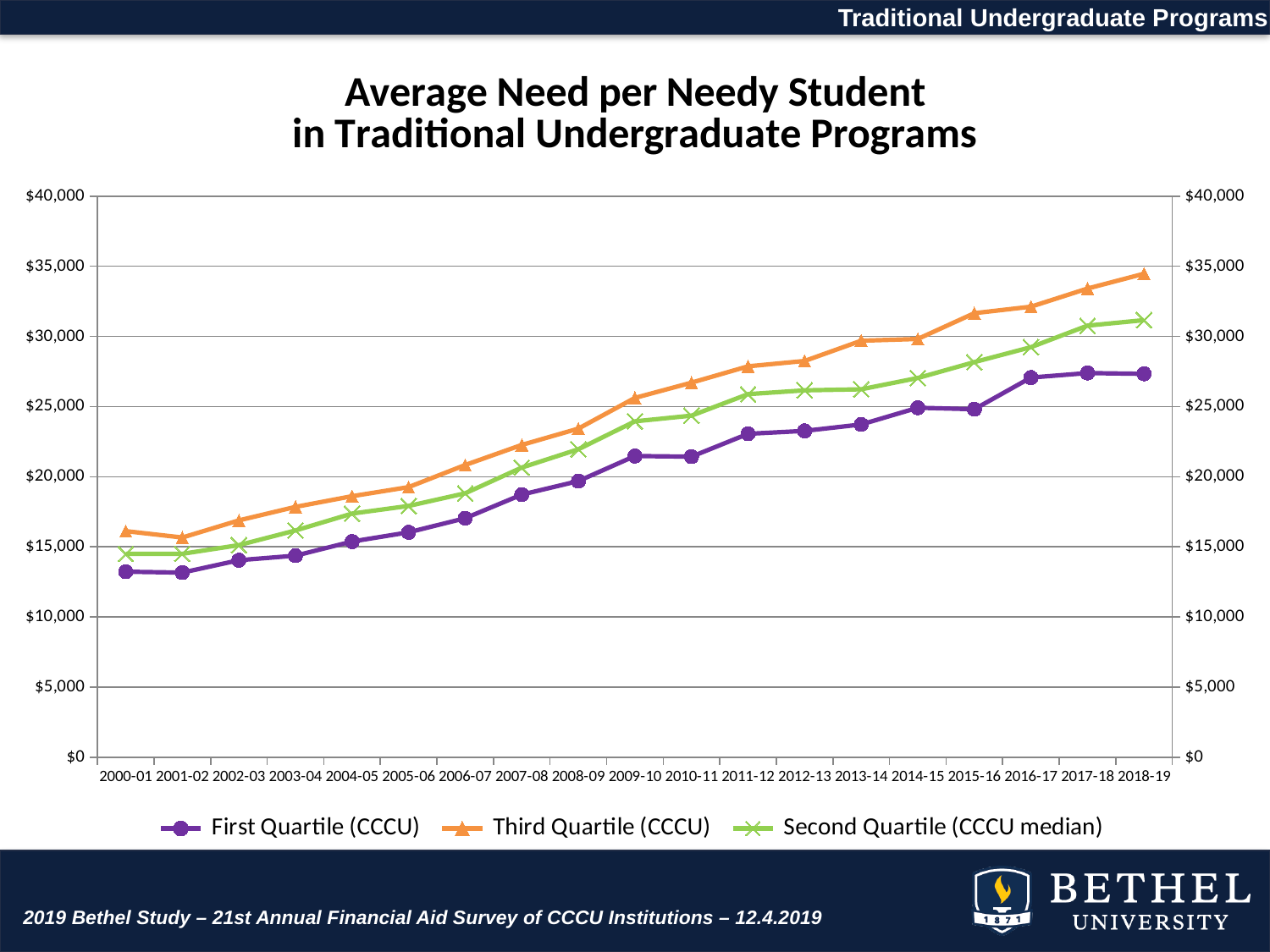
How many academic years are plotted along the x axis? 19 Is the Third Quartile (CCCU) value for 2018-19 greater or less than $30,000? greater Which series is plotted with the orange triangle markers? Third Quartile (CCCU) How many series does the legend list? 3 What kind of chart is shown on the slide? line chart In which academic year is the Third Quartile (CCCU) value highest? 2018-19 What is the title of the chart? Average Need per Needy Student in Traditional Undergraduate Programs In 2018-19, which is larger: the Third Quartile (CCCU) value or the First Quartile (CCCU) value? Third Quartile (CCCU) Is the Second Quartile (CCCU median) value for 2018-19 greater or less than $30,000? greater Do the Third Quartile (CCCU) values generally rise or fall from 2000-01 to 2018-19? rise Is the First Quartile (CCCU) value for 2000-01 greater or less than $15,000? less